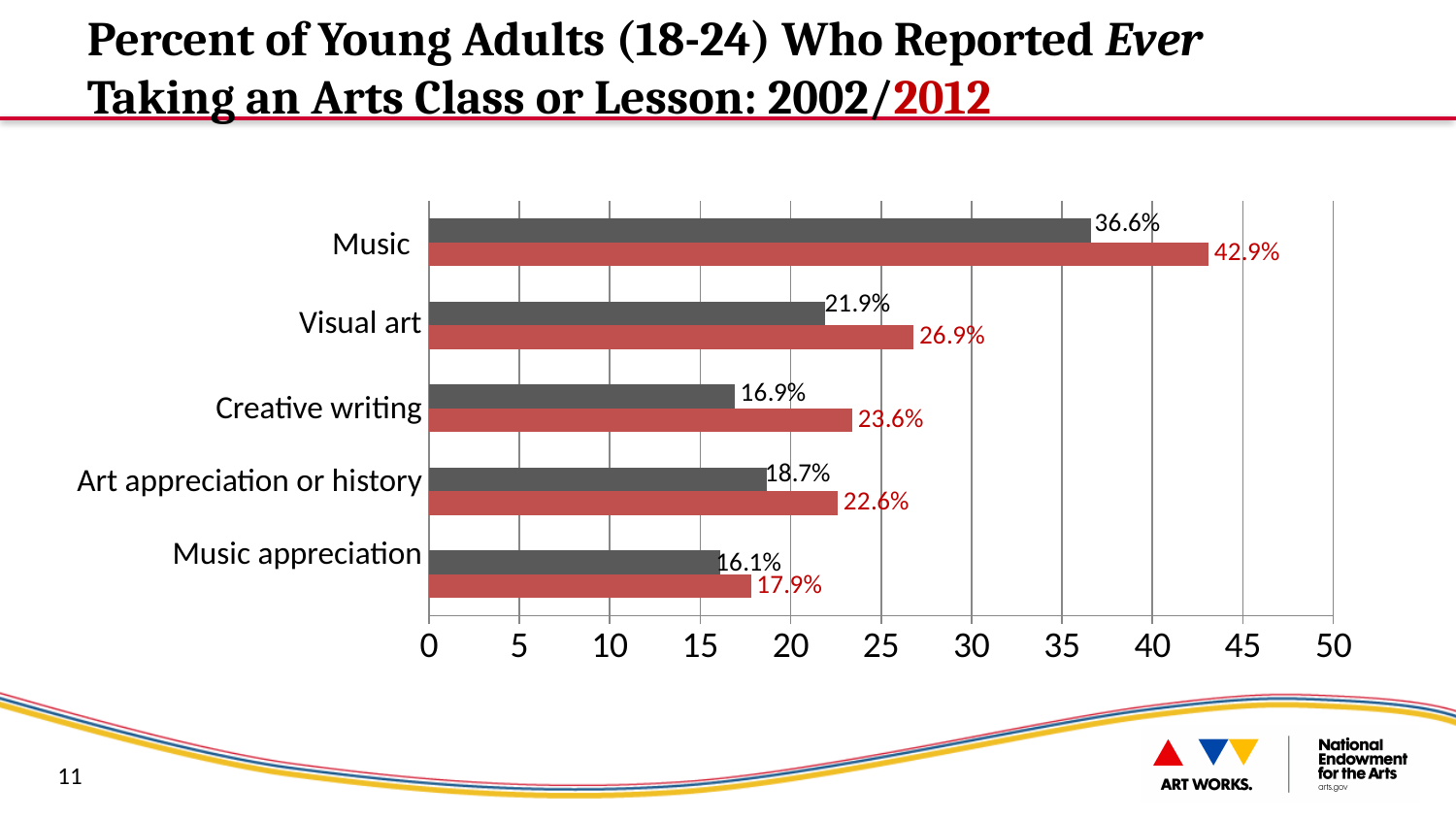
Which is larger: the 2002 value for Art appreciation or history or the 2002 value for Creative writing? Art appreciation or history How many categories are shown on the chart? 5 What is the 2002 (gray bar) value for Music appreciation? 16.1% What is the difference between the 2012 and 2002 values for Music? 6.3% Which category has the lowest 2002 (gray bar) value? Music appreciation What percent of young adults reported ever taking a music class or lesson in 2012 (red bar)? 42.9% What is the 2002 (gray bar) value for Visual art? 21.9% What kind of chart is shown on the slide? Bar chart What is the maximum value shown on the horizontal axis? 50 Which category has the highest 2012 (red bar) value? Music What is the 2012 (red bar) value for Creative writing? 23.6% What is the difference between the 2012 and 2002 values for Art appreciation or history? 3.9%